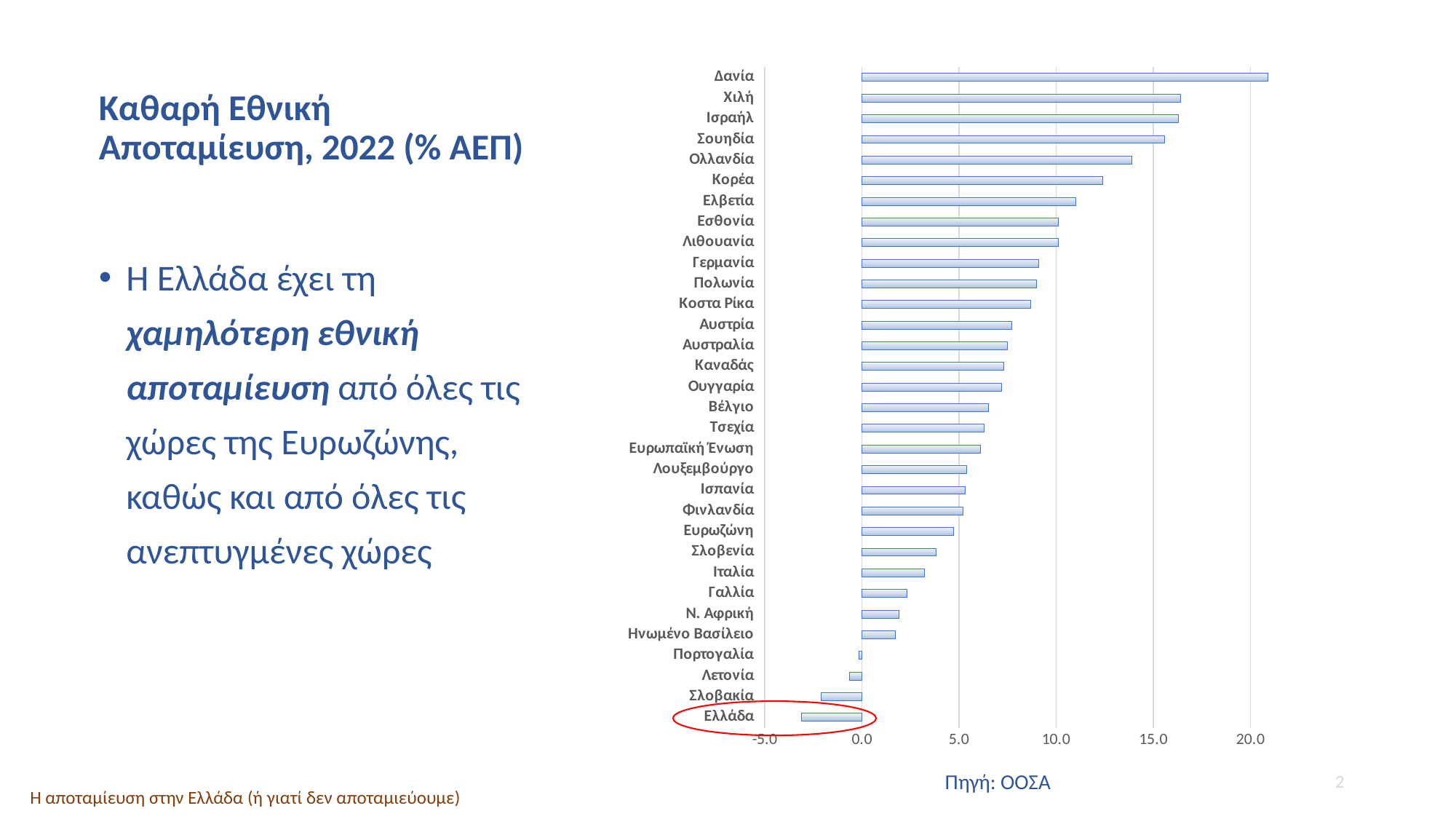
Is the value for Ολλανδία greater or less than 15.0? less Is the value for Κορέα greater or less than 10.0? greater What is the source of the data cited below the chart? ΟΟΣΑ Is the value for Ελλάδα greater or less than 0.0? less Do the bar values rise or fall going from the top of the chart to the bottom? fall Which country has the lowest net national saving in the chart? Ελλάδα What kind of chart is shown on the slide? bar chart Which has the larger value, Σουηδία or Ολλανδία? Σουηδία Which country has the highest net national saving in the chart? Δανία How many countries or regions are listed in the chart? 32